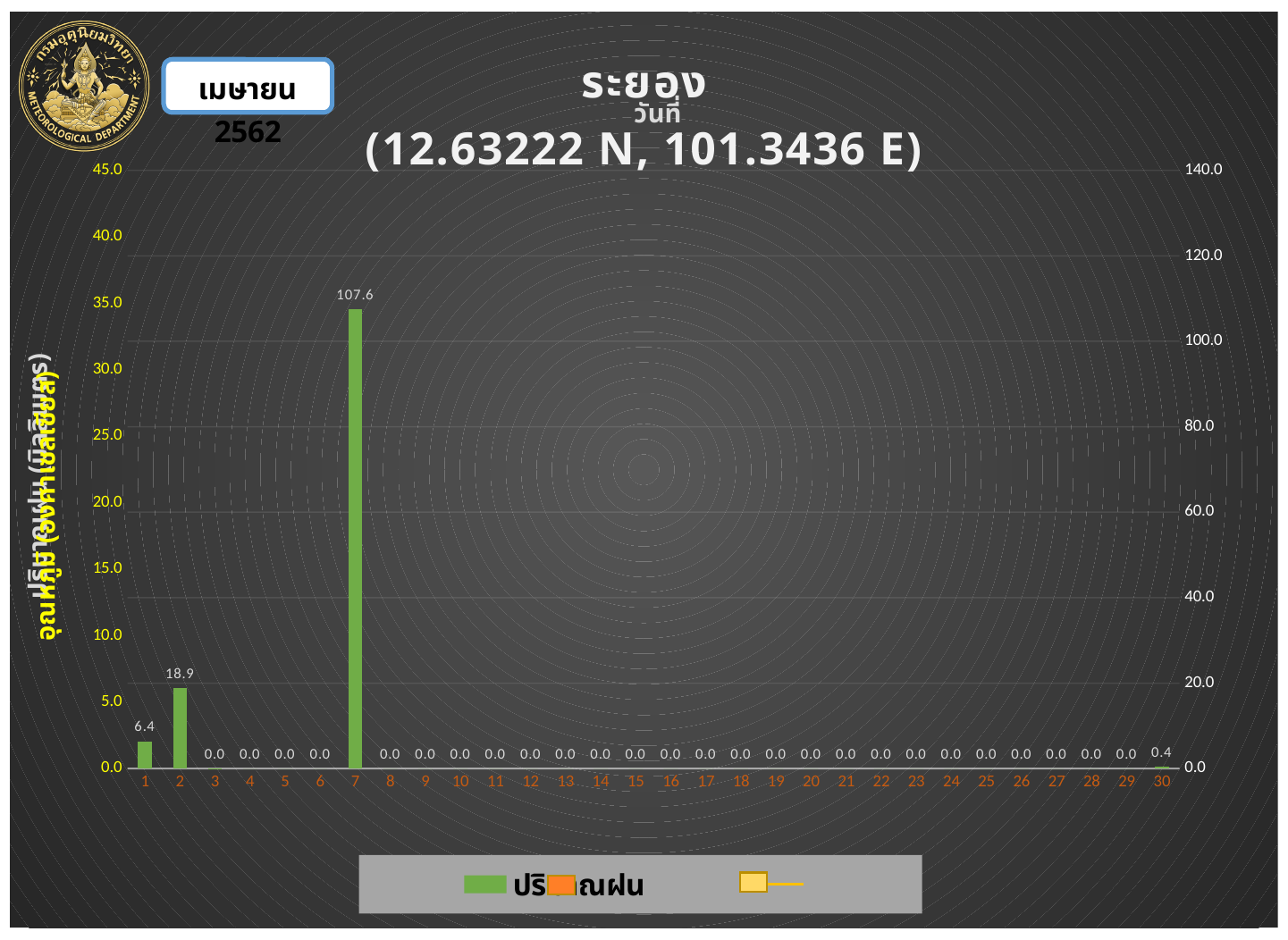
What kind of chart is shown on the slide? bar chart What is the rainfall value shown for day 15? 0.0 What is the rainfall value shown for day 30? 0.4 Which day has the highest rainfall value? 7 What is the difference between the rainfall values for day 2 and day 1? 12.5 How many days are shown on the x axis? 30 What is the rainfall value shown for day 7? 107.6 What is the rainfall value shown for day 1? 6.4 Which is larger, the rainfall value for day 1 or for day 30? day 1 Is the rainfall value for day 7 greater or less than 100.0 on the right axis? greater What is the rainfall value shown for day 2? 18.9 What is the difference between the rainfall values for day 7 and day 2? 88.7